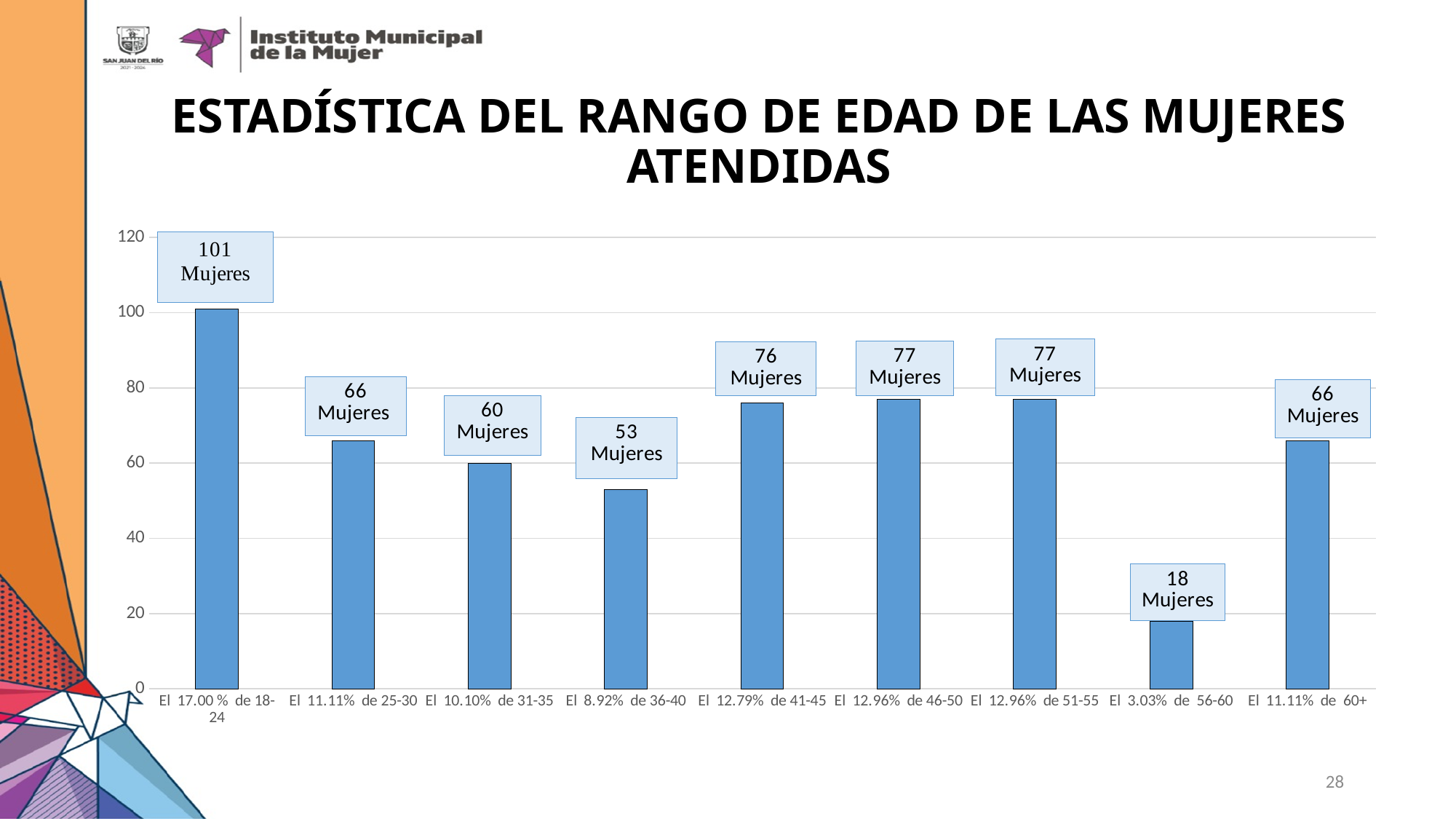
How many women are in the 18-24 age range? 101 Mujeres Which has more women attended, the 31-35 range or the 41-45 range? 41-45 Which age range has the highest number of women attended? 18-24 Which age range has the lowest number of women attended? 56-60 How many age range categories are shown on the chart? 9 What is the difference between the number of women in the 18-24 range and the 25-30 range? 35 What percentage is shown for the 36-40 age range? 8.92% What is the difference between the number of women in the 46-50 range and the 56-60 range? 59 What is the title of the chart on the slide? ESTADÍSTICA DEL RANGO DE EDAD DE LAS MUJERES ATENDIDAS What kind of chart is shown on the slide? Bar chart How many women are in the 56-60 age range? 18 Mujeres How many women are in the 36-40 age range? 53 Mujeres